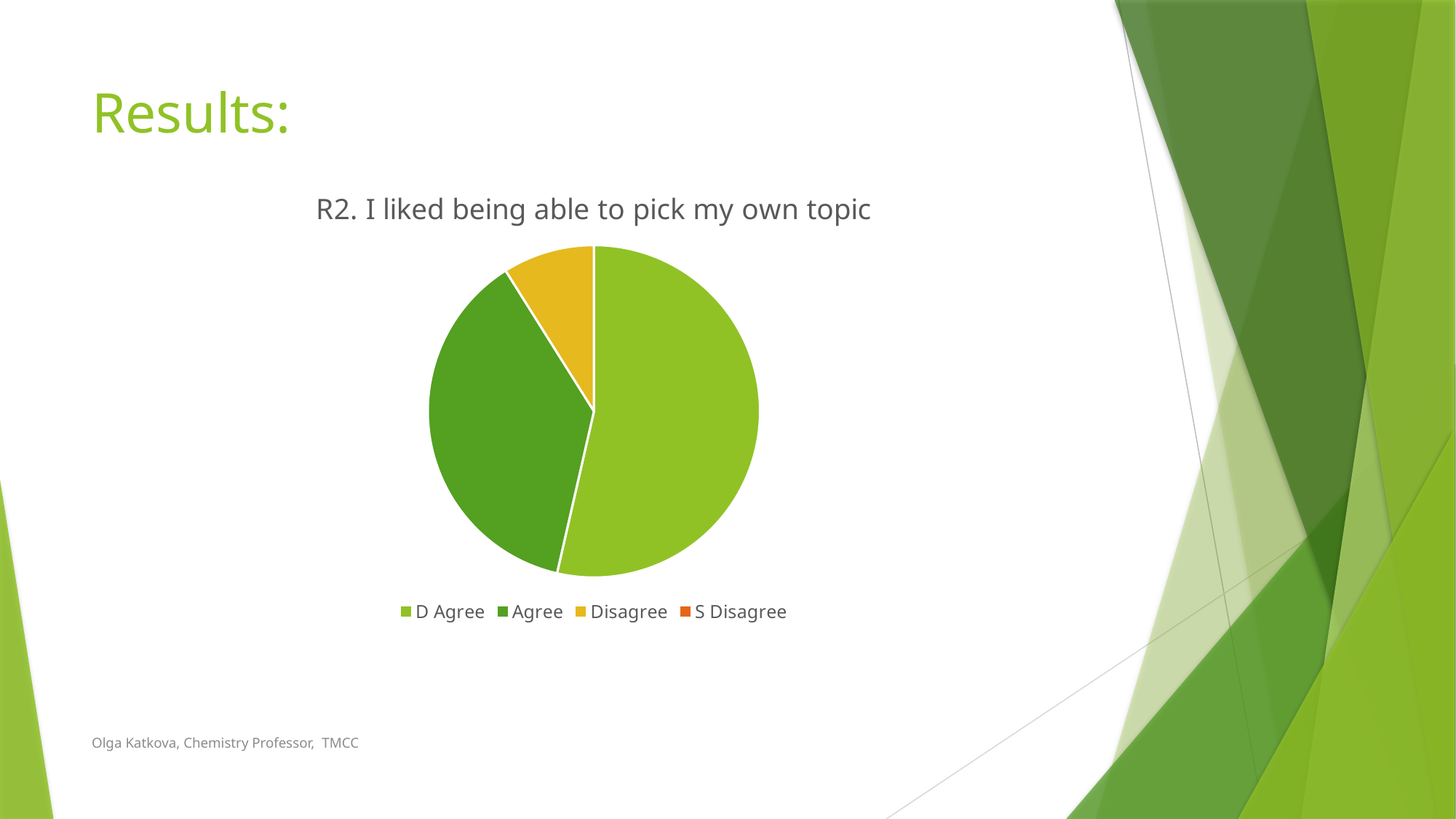
Which legend entry has no visible slice in the pie? S Disagree Does the D Agree slice take up more or less than half of the pie? more Which slice is larger, Agree or Disagree? Agree How many categories does the chart's legend list? 4 Of the slices visible in the pie, which is the smallest? Disagree What kind of chart is shown on the slide? pie chart Which category has the largest slice of the pie? D Agree How many slices are visible in the pie? 3 Which slice is larger, D Agree or Agree? D Agree What is the title of the chart? R2. I liked being able to pick my own topic